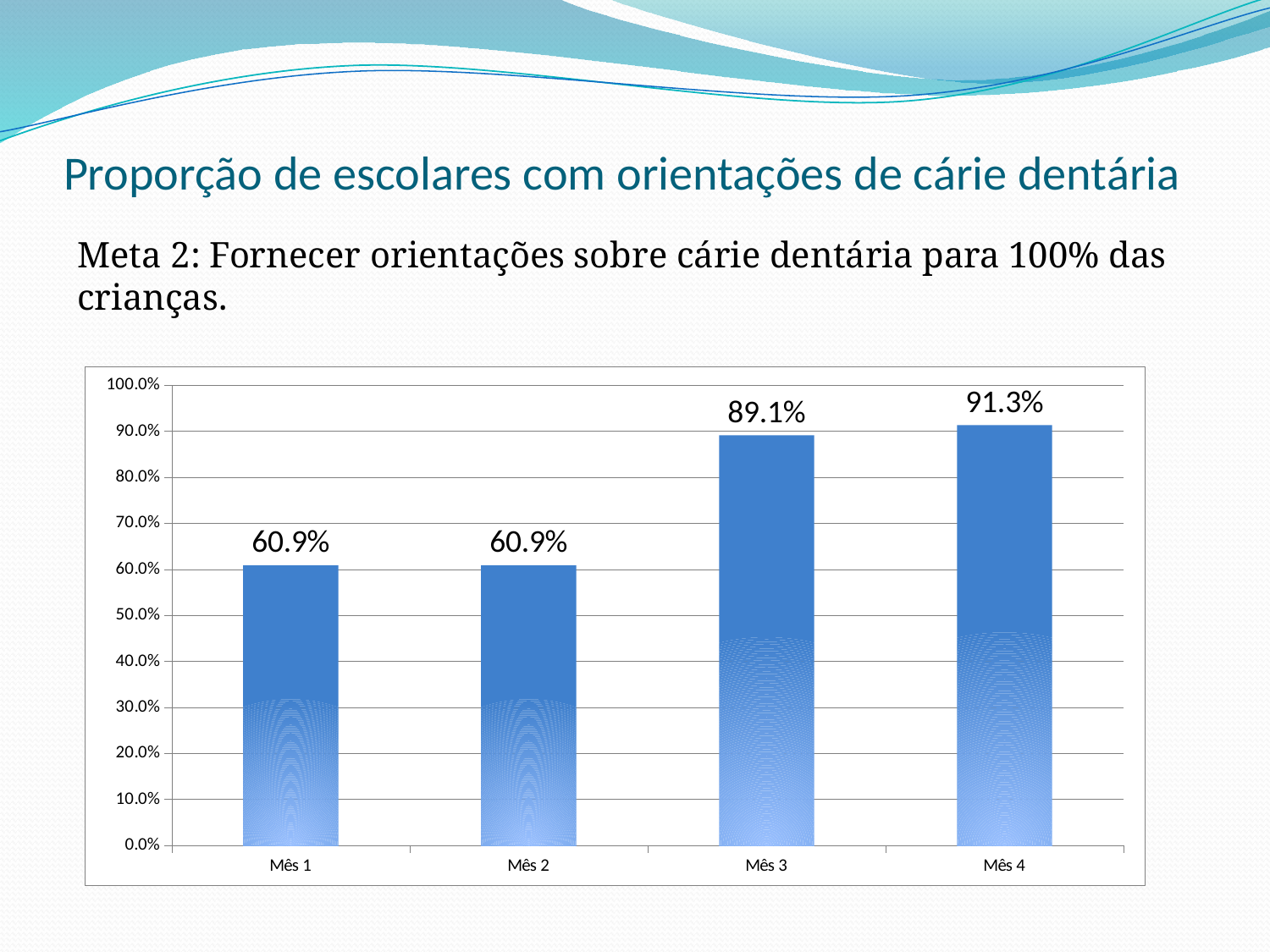
Is the value for Mês 2 greater or less than 70.0%? less What is the value for Mês 4? 91.3% What kind of chart is shown on the slide? bar chart What is the value for Mês 3? 89.1% Which month has the highest value? Mês 4 How many months are shown on the x axis? 4 What is the difference between the values for Mês 3 and Mês 2? 28.2% What is the value for Mês 1? 60.9% Which is larger, the value for Mês 3 or the value for Mês 1? Mês 3 Is the value for Mês 4 greater or less than 90.0%? greater Do the values rise or fall from Mês 1 to Mês 4? rise What is the difference between the values for Mês 4 and Mês 3? 2.2%